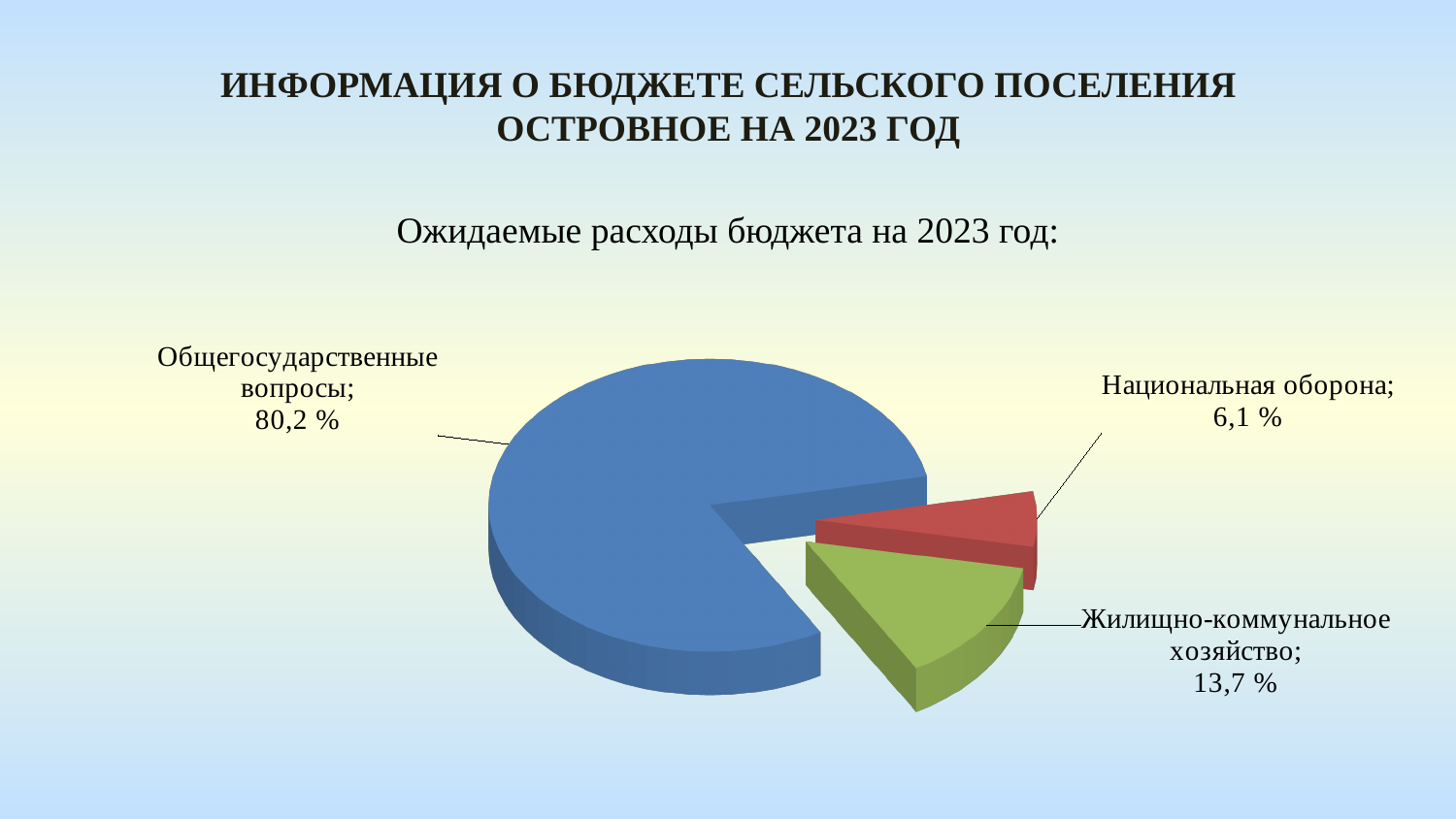
What colour is the slice for Национальная оборона? Red What share of the pie does Общегосударственные вопросы have? 80,2 % What is the subtitle above the chart? Ожидаемые расходы бюджета на 2023 год: What is the value shown for Жилищно-коммунальное хозяйство? 13,7 % What is the value shown for Национальная оборона? 6,1 % What is the difference between the shares of Жилищно-коммунальное хозяйство and Национальная оборона? 7,6 % What kind of chart is shown on the slide? Pie chart Which category has the smallest slice of the pie? Национальная оборона What is the difference between the shares of Общегосударственные вопросы and Жилищно-коммунальное хозяйство? 66,5 % Which is larger: the share for Жилищно-коммунальное хозяйство or the share for Национальная оборона? Жилищно-коммунальное хозяйство Which category has the largest slice of the pie? Общегосударственные вопросы How many categories are shown in the pie chart? 3